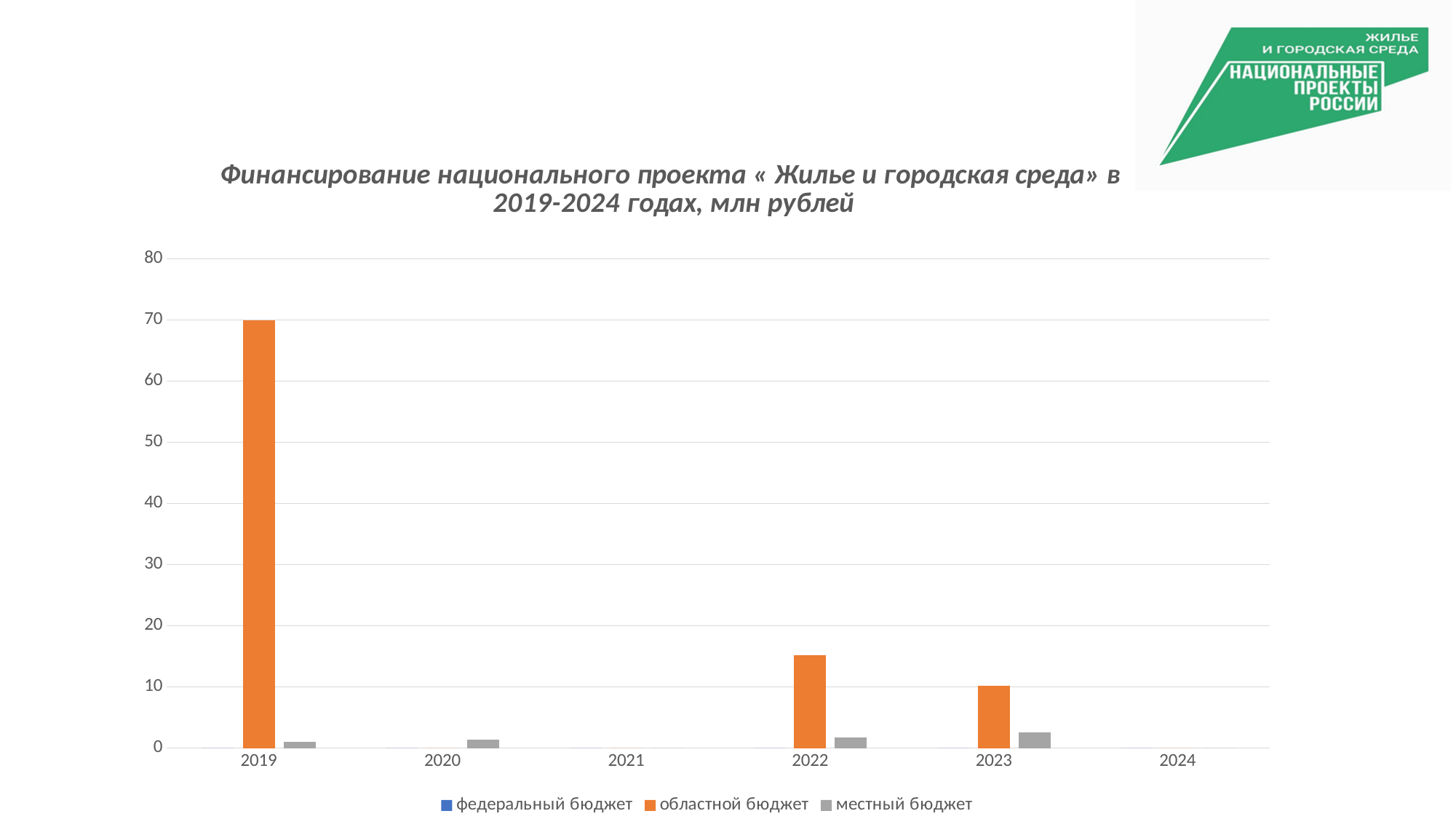
Is the областной бюджет value for 2019 greater or less than 60? greater In which year is the областной бюджет value highest? 2019 What kind of chart is shown on the slide? bar chart What unit of measurement is stated in the chart title? млн рублей Which colour represents областной бюджет in the chart legend? orange How many years are shown on the x axis of the chart? 6 Is the местный бюджет value for 2023 greater or less than 10? less How many series does the chart legend list? 3 Which is larger, the областной бюджет value for 2022 or for 2023? 2022 Is the областной бюджет value for 2022 greater or less than 10? greater In which year is the местный бюджет value highest? 2023